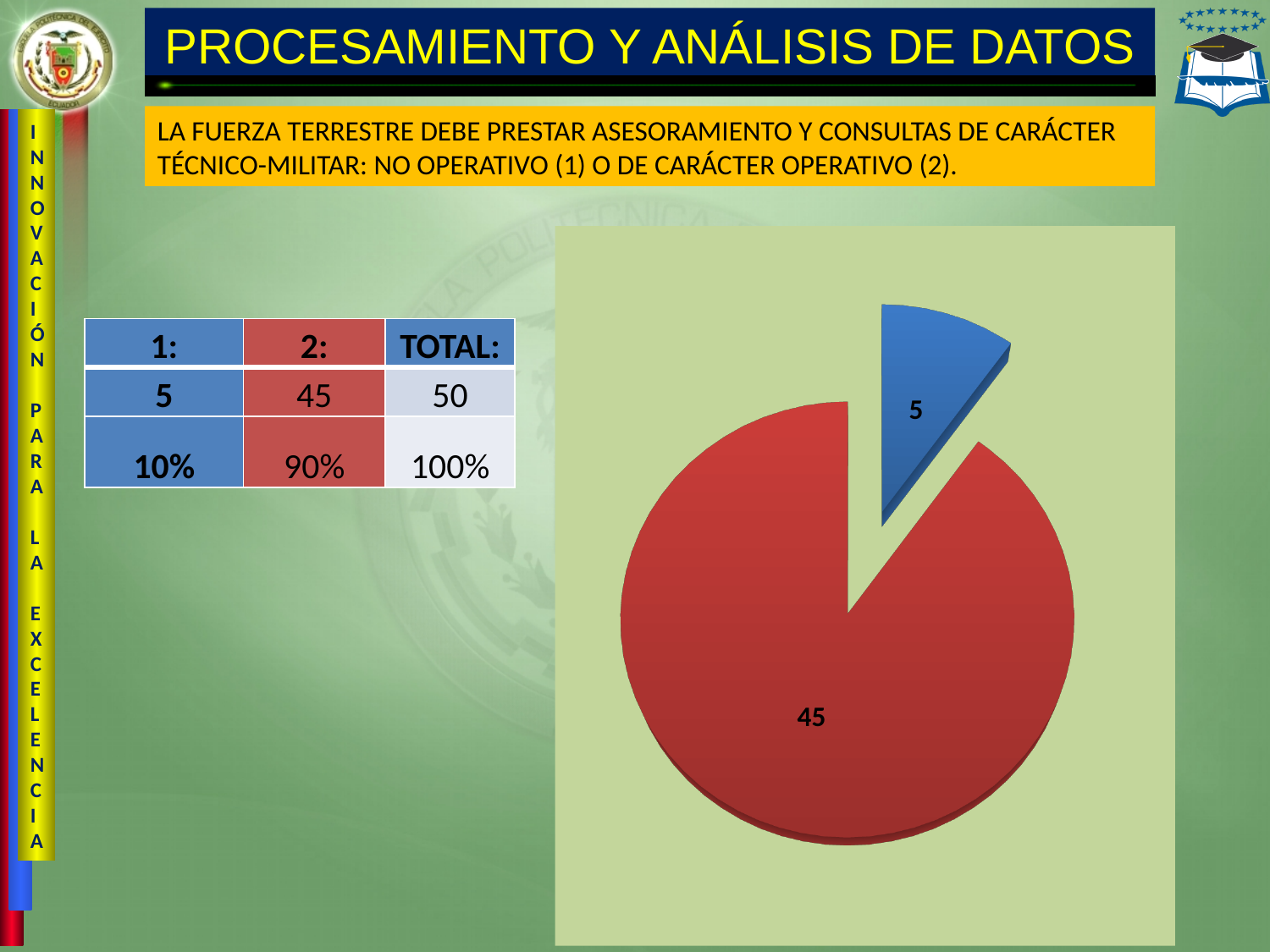
What is the difference between the red slice value and the blue slice value in the pie chart? 40 Which slice of the pie chart is pulled out (exploded) from the rest of the pie? the blue slice How many slices does the pie chart have? 2 Which slice of the pie chart has the smallest value? the blue slice (5) What share of the pie does the red slice (45) represent? 90% Which slice of the pie chart has the largest value? the red slice (45) What share of the pie does the blue slice (5) represent? 10% What kind of chart is shown on the slide? pie chart Is the red slice or the blue slice of the pie chart larger? the red slice What value is labelled on the red slice of the pie chart? 45 What is the total of the two slice values in the pie chart? 50 What value is labelled on the blue slice of the pie chart? 5